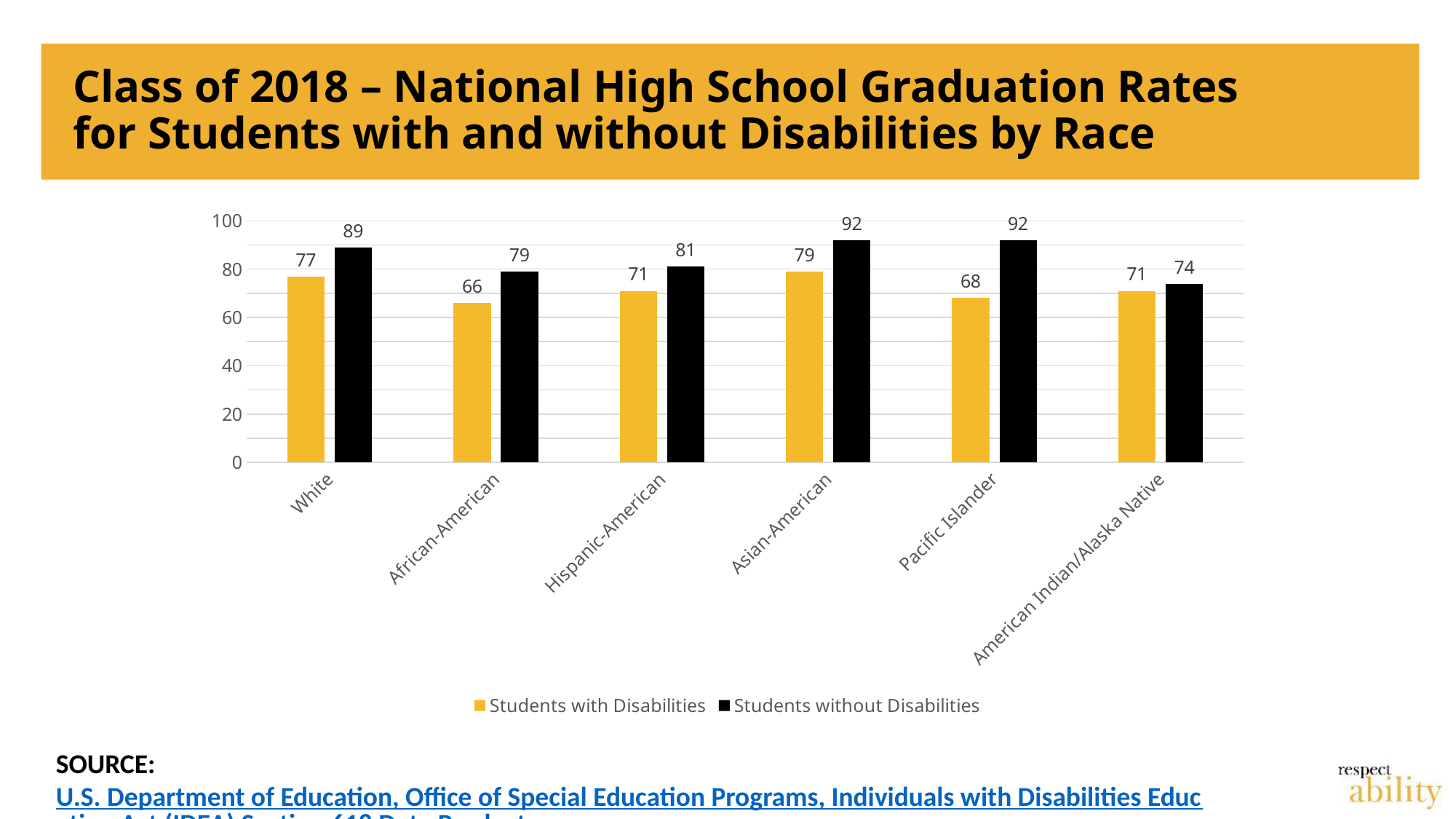
What is the difference between the graduation rates of Students without Disabilities and Students with Disabilities for Pacific Islander? 24 What is the graduation rate for White Students with Disabilities? 77 Which race category has the lowest graduation rate for Students with Disabilities? African-American What is the difference between the graduation rates of Students without Disabilities and Students with Disabilities for African-American? 13 What kind of chart is shown on the slide? Bar chart Which is larger: the graduation rate for Hispanic-American Students with Disabilities or for White Students with Disabilities? White Students with Disabilities How many series does the legend list? 2 Is the graduation rate for Pacific Islander Students with Disabilities greater or less than 80? less How many race categories are shown on the x axis? 6 What is the graduation rate for Asian-American Students without Disabilities? 92 What is the graduation rate for American Indian/Alaska Native Students with Disabilities? 71 Which race category has the highest graduation rate for Students with Disabilities? Asian-American